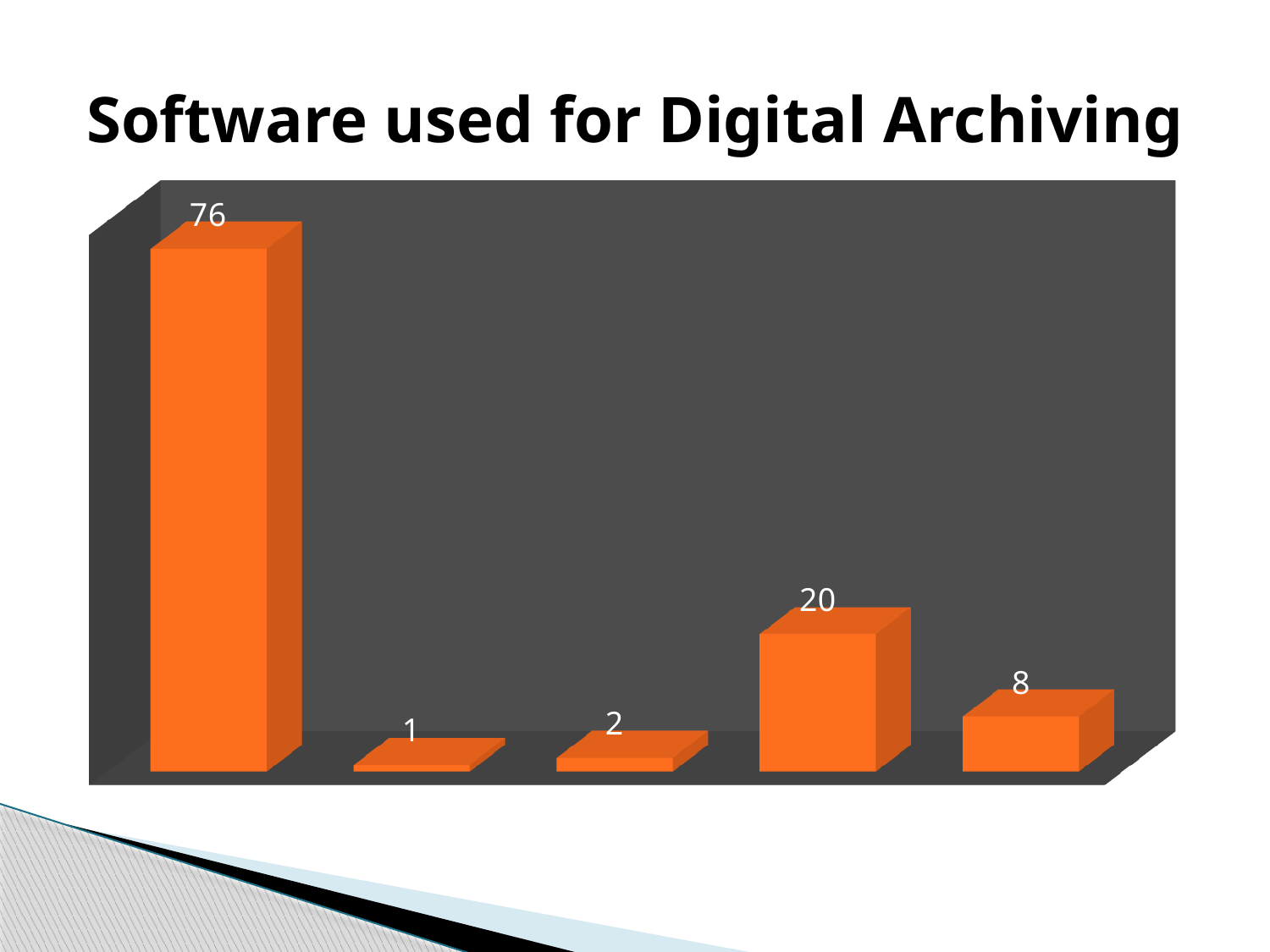
How many bars are plotted in the chart? 5 What is the difference between the rightmost bar (8) and the third bar from the left (2)? 6 What is the value of the fourth bar from the left in the chart? 20 What is the lowest value shown in the chart? 1 What type of chart is shown on the slide? bar chart Which is larger, the fourth bar from the left or the rightmost bar? the fourth bar (20) What is the title of the chart on the slide? Software used for Digital Archiving What is the highest value shown in the chart? 76 What is the value of the second bar from the left in the chart? 1 What is the value of the last (rightmost) bar in the chart? 8 What is the difference between the first bar (76) and the fourth bar (20)? 56 What is the value of the first (leftmost) bar in the chart? 76